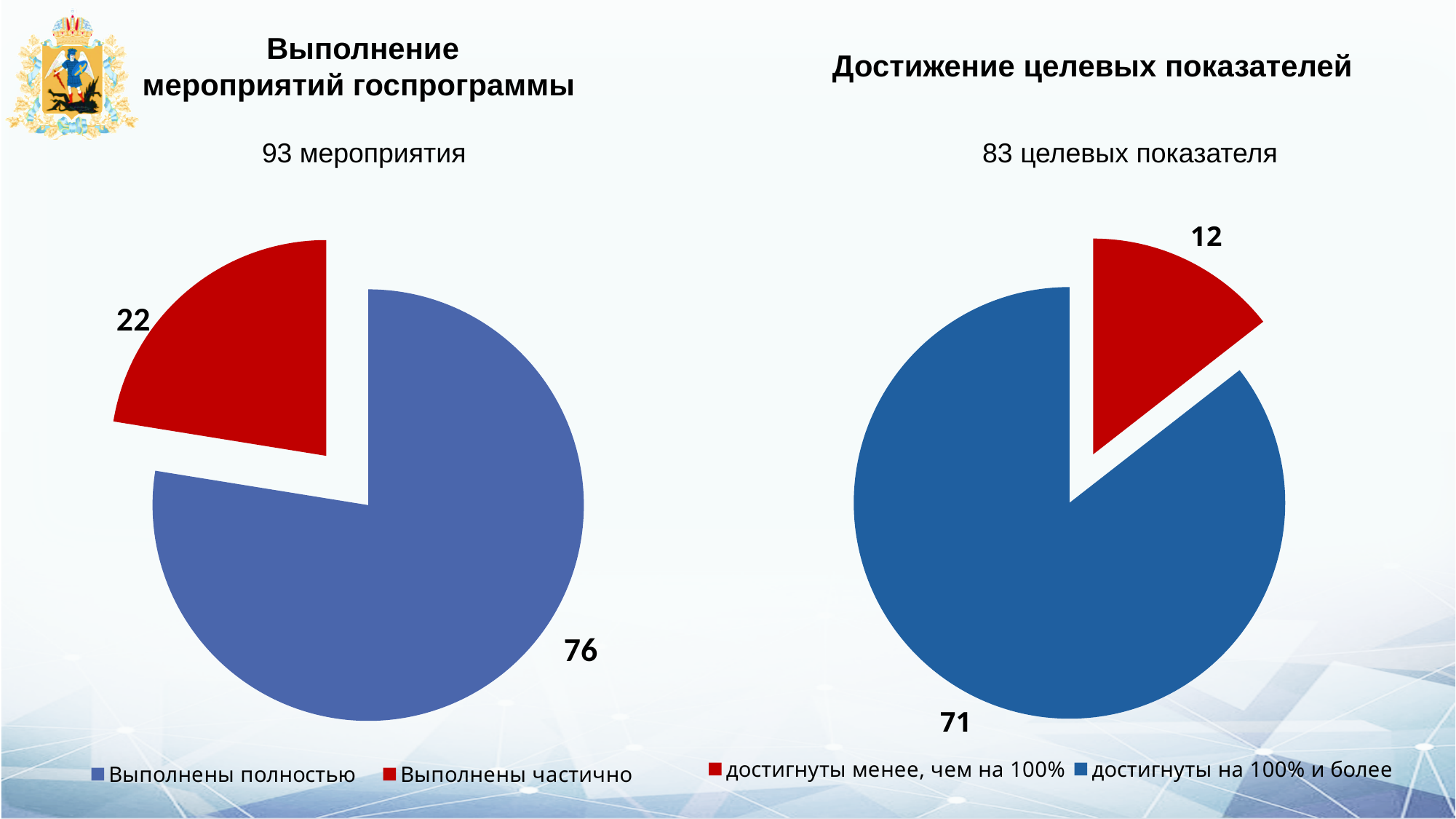
How many categories does the legend of the left chart "Выполнение мероприятий госпрограммы" list? 2 In the right chart "Достижение целевых показателей", what is the value for "достигнуты менее, чем на 100%"? 12 In the right chart "Достижение целевых показателей", what is the total of the two slices? 83 In the left chart "Выполнение мероприятий госпрограммы", which category has the largest slice? Выполнены полностью What kind of chart is used on the left, titled "Выполнение мероприятий госпрограммы"? Pie chart In the right chart "Достижение целевых показателей", which category has the smallest slice? достигнуты менее, чем на 100% In the left chart "Выполнение мероприятий госпрограммы", what is the difference between "Выполнены полностью" and "Выполнены частично"? 54 In the left chart "Выполнение мероприятий госпрограммы", what is the value for "Выполнены полностью"? 76 In the right chart "Достижение целевых показателей", what colour is the slice for "достигнуты менее, чем на 100%"? Red In the right chart "Достижение целевых показателей", what is the value for "достигнуты на 100% и более"? 71 In the right chart "Достижение целевых показателей", what is the difference between "достигнуты на 100% и более" and "достигнуты менее, чем на 100%"? 59 In the left chart "Выполнение мероприятий госпрограммы", what is the value for "Выполнены частично"? 22